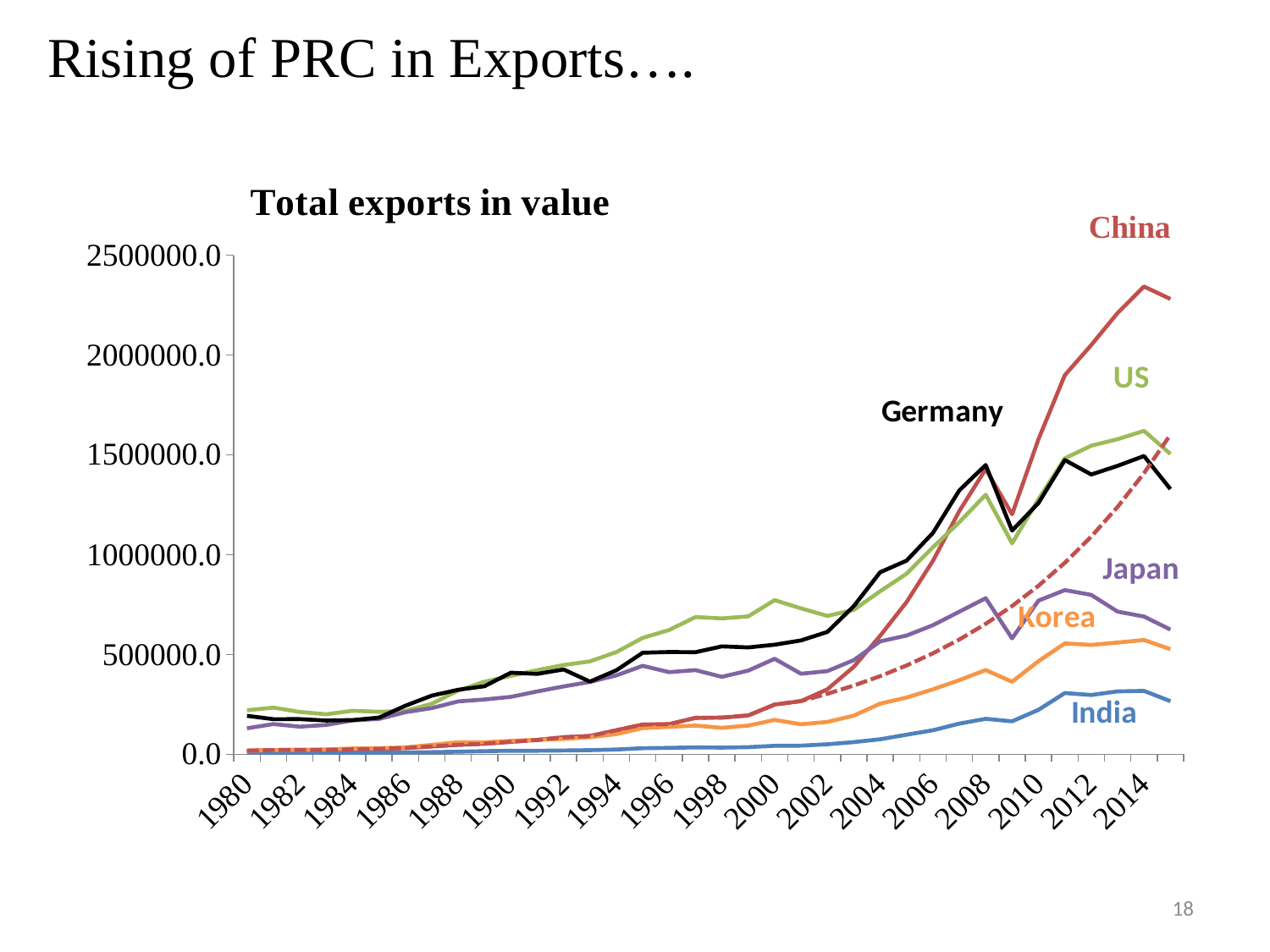
How many countries are labelled on the chart? 6 In 2014, which has the larger total exports in value, the US or Germany? US Which country has the highest total exports in value in 2014? China Is the value for China in 2014 greater or less than 2000000.0? greater What kind of chart is shown on the slide? line chart What colour is the line for China? red Which country has the lowest total exports in value in 2014? India Is the value for Germany in 2008 greater or less than 1000000.0? greater Is the value for India in 2014 greater or less than 500000.0? less What is the title of the chart? Total exports in value Does the value for China rise or fall between 2000 and 2014? rise